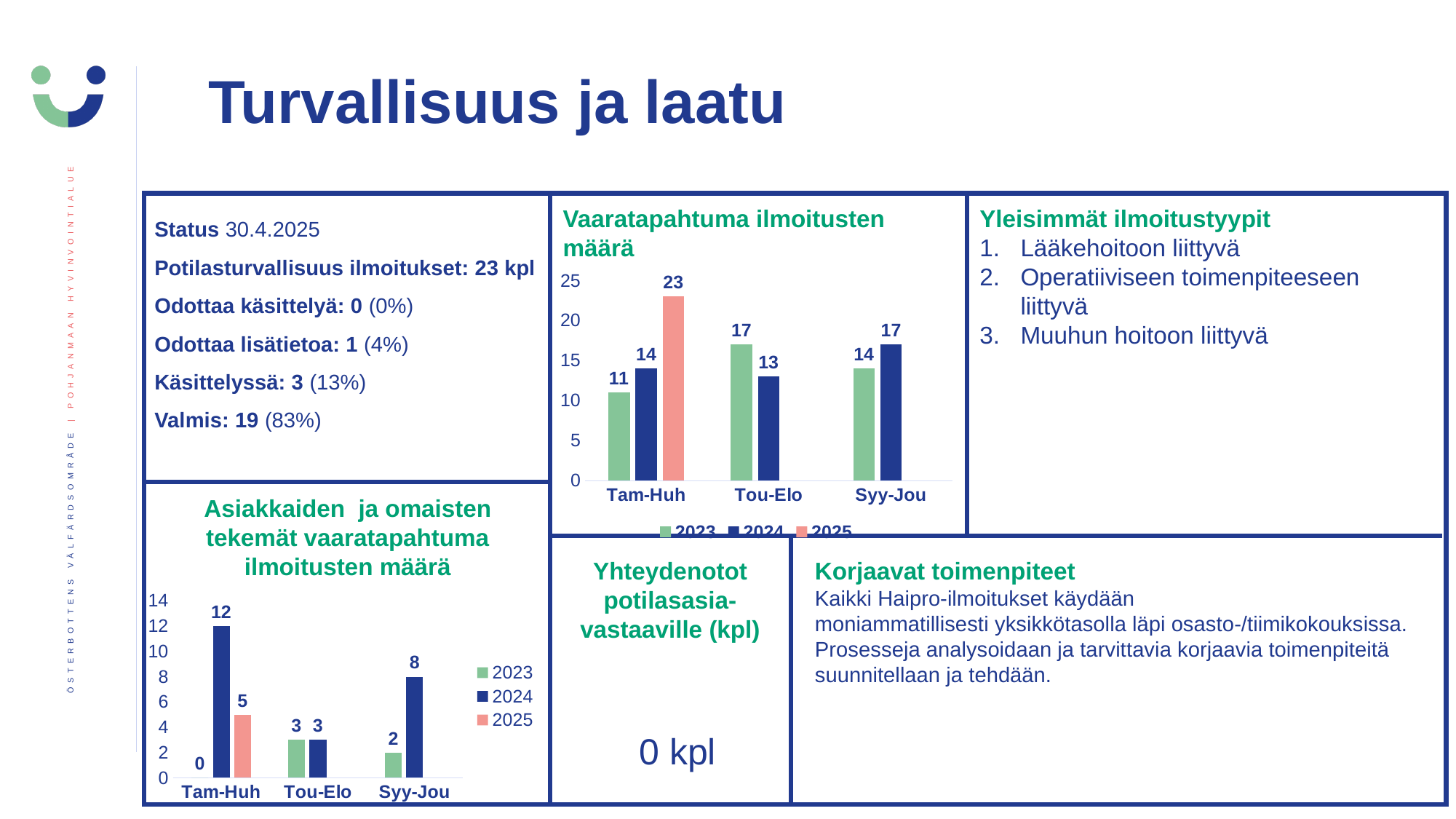
What kind of chart is 'Vaaratapahtuma ilmoitusten määrä'? bar chart In the 'Vaaratapahtuma ilmoitusten määrä' chart, what is the value for 2025 in Tam-Huh? 23 In the 'Vaaratapahtuma ilmoitusten määrä' chart, what is the value for 2023 in Tou-Elo? 17 In the 'Asiakkaiden ja omaisten tekemät vaaratapahtuma ilmoitusten määrä' chart, what is the value for 2024 in Tam-Huh? 12 How many period categories are shown on the x axis of the 'Asiakkaiden ja omaisten tekemät vaaratapahtuma ilmoitusten määrä' chart? 3 In the 'Vaaratapahtuma ilmoitusten määrä' chart, how many series does the legend list? 3 In the 'Asiakkaiden ja omaisten tekemät vaaratapahtuma ilmoitusten määrä' chart, what is the difference between the 2024 values in Tam-Huh and Syy-Jou? 4 In the 'Vaaratapahtuma ilmoitusten määrä' chart, which period has the highest 2024 value? Syy-Jou In the 'Vaaratapahtuma ilmoitusten määrä' chart, which is larger in Tou-Elo: the 2023 value or the 2024 value? 2023 In the 'Asiakkaiden ja omaisten tekemät vaaratapahtuma ilmoitusten määrä' chart, what is the value for 2023 in Syy-Jou? 2 In the 'Vaaratapahtuma ilmoitusten määrä' chart, what is the difference between the 2025 and 2023 values in Tam-Huh? 12 In the 'Asiakkaiden ja omaisten tekemät vaaratapahtuma ilmoitusten määrä' chart, which period has the lowest 2023 value? Tam-Huh